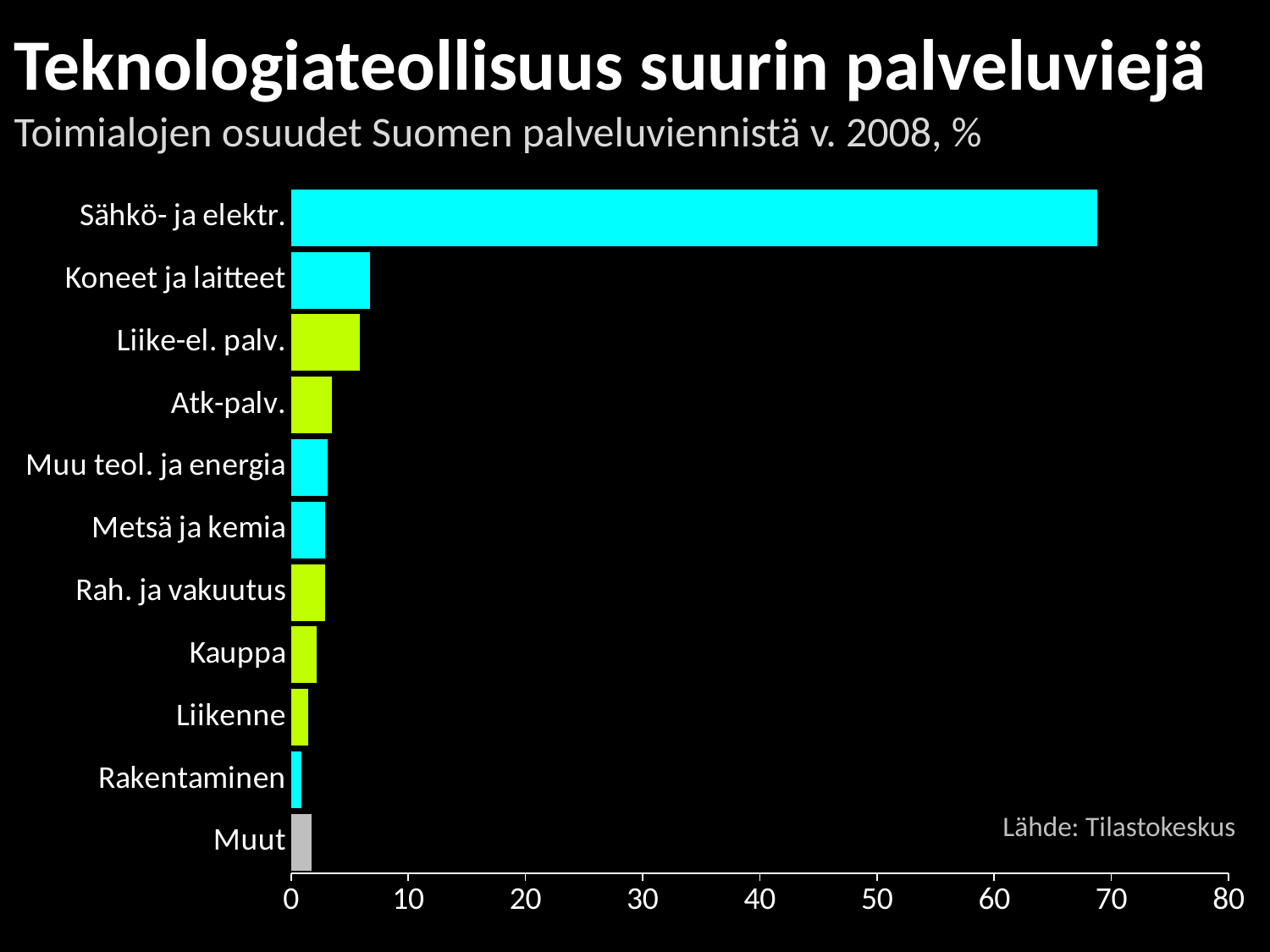
Which is larger, the value for Koneet ja laitteet or the value for Liike-el. palv.? Koneet ja laitteet What source is cited for the chart data? Tilastokeskus Which is larger, the value for Kauppa or the value for Rakentaminen? Kauppa Is the value for Koneet ja laitteet greater or less than 10? less How many categories (industries) are shown in the chart? 11 Is the value for Sähkö- ja elektr. greater or less than 60? greater Which category has the highest share of Finland's service exports? Sähkö- ja elektr. Is the value for Sähkö- ja elektr. greater or less than 70? less What kind of chart is shown on the slide? bar chart Which category has the lowest share of Finland's service exports? Rakentaminen